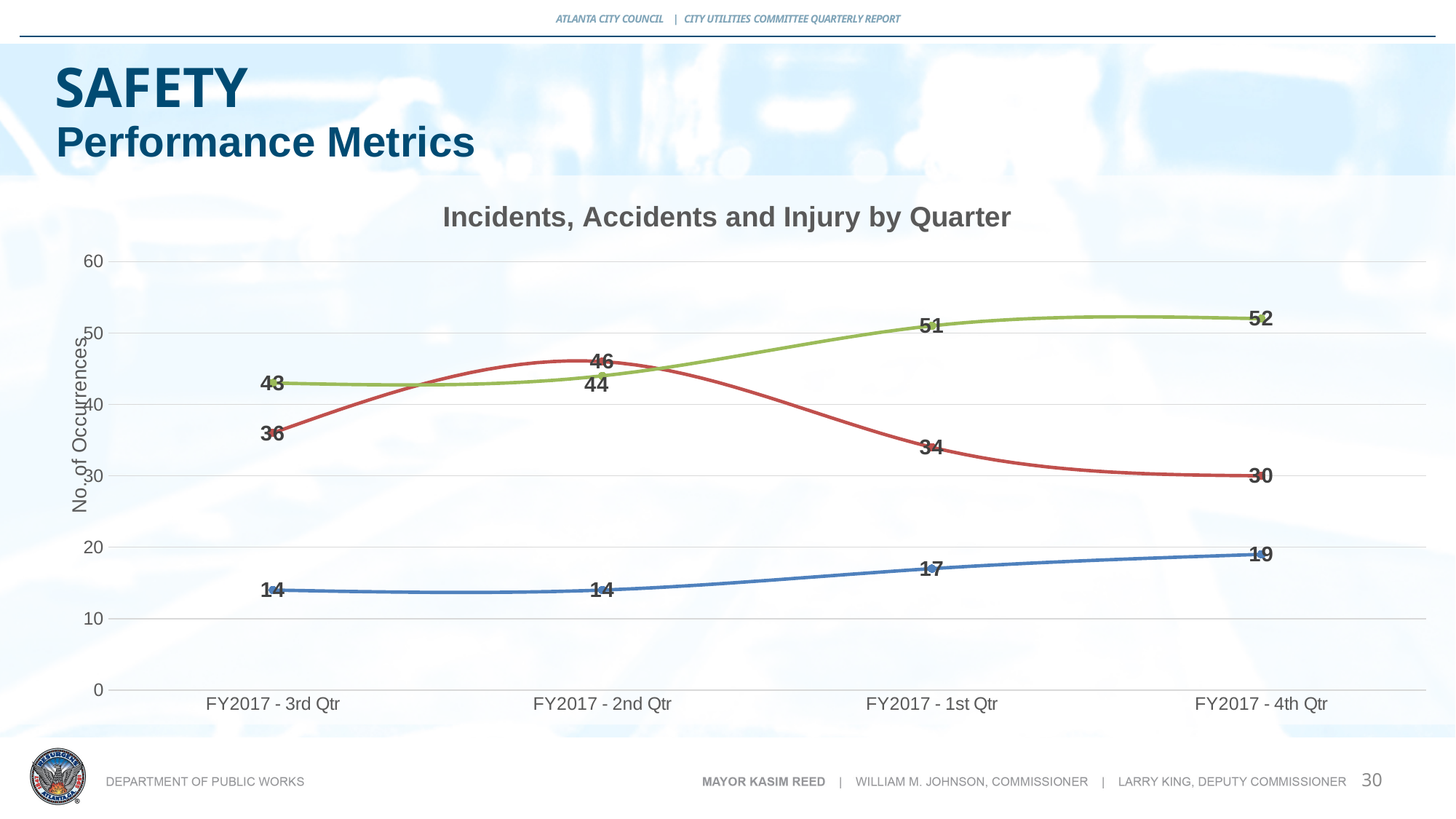
What is the value of the blue line at FY2017 - 1st Qtr? 17 What is the value of the red line at FY2017 - 2nd Qtr? 46 At which quarter does the red line reach its highest value? FY2017 - 2nd Qtr What is the difference between the green line and the red line at FY2017 - 4th Qtr? 22 Does the blue line rise or fall from FY2017 - 2nd Qtr to FY2017 - 4th Qtr? rise At which quarter does the red line reach its lowest value? FY2017 - 4th Qtr What is the label of the y axis? No. of Occurrences At FY2017 - 2nd Qtr, which is larger: the red line value or the green line value? red line What type of chart is shown on the slide? line chart What is the value of the green line at FY2017 - 4th Qtr? 52 What is the title of the chart? Incidents, Accidents and Injury by Quarter How many quarters are plotted along the x axis? 4